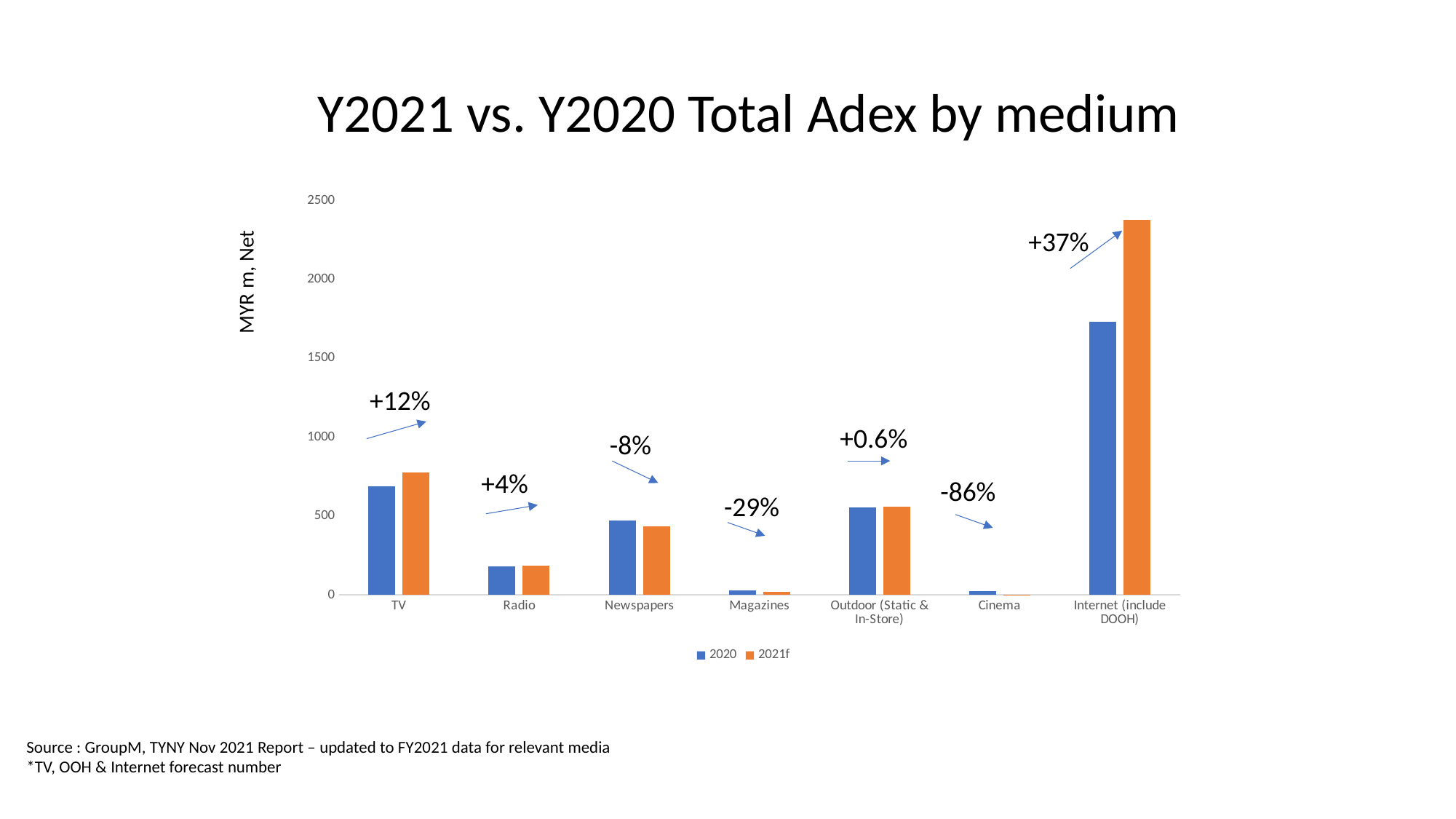
Is the 2020 value for Radio greater or less than 500? less How many series does the legend list? 2 What percentage change is annotated for Internet (include DOOH)? +37% What percentage change is annotated for Magazines? -29% What type of chart is shown on the slide? bar chart Which medium has the lowest 2021f value? Cinema What percentage change is annotated for Outdoor (Static & In-Store)? +0.6% What percentage change is annotated for Cinema? -86% Is the 2021f value for Internet (include DOOH) greater or less than 2000? greater Which is larger for TV, the 2020 value or the 2021f value? 2021f Which medium has the highest 2021f value? Internet (include DOOH) How many media categories are shown on the x axis? 7